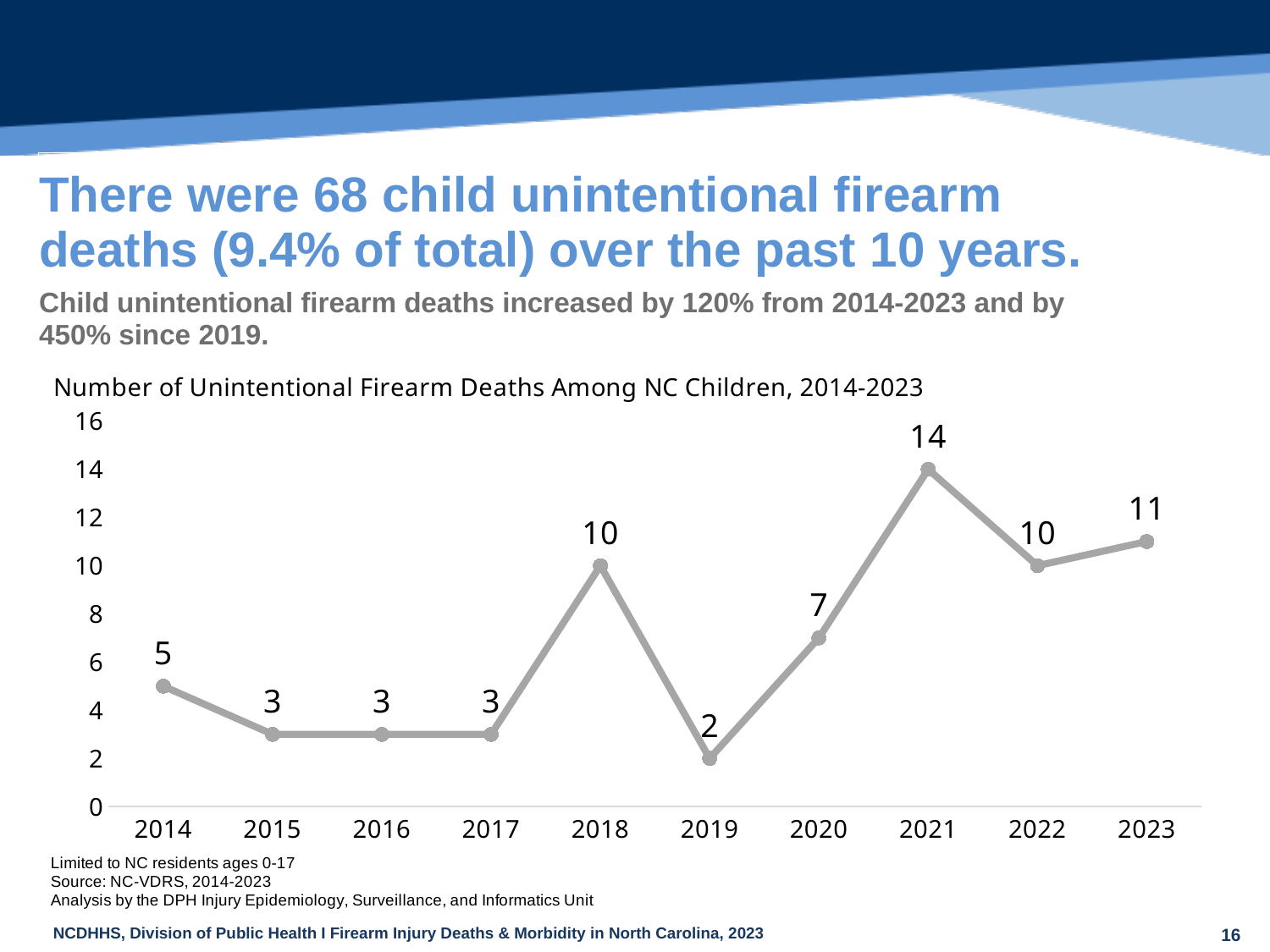
Which year has the highest number of unintentional firearm deaths? 2021 How many years are plotted on the chart? 10 Which year has the lowest number of unintentional firearm deaths? 2019 What is the difference between the values for 2021 and 2019? 12 What is the title of the chart? Number of Unintentional Firearm Deaths Among NC Children, 2014-2023 What is the value plotted for 2014? 5 Do the values rise or fall from 2019 to 2021? Rise What is the number of unintentional firearm deaths among NC children in 2021? 14 Which year has a larger value, 2018 or 2020? 2018 What is the difference between the values for 2023 and 2014? 6 What kind of chart is shown on the slide? Line chart What is the value plotted for 2019? 2